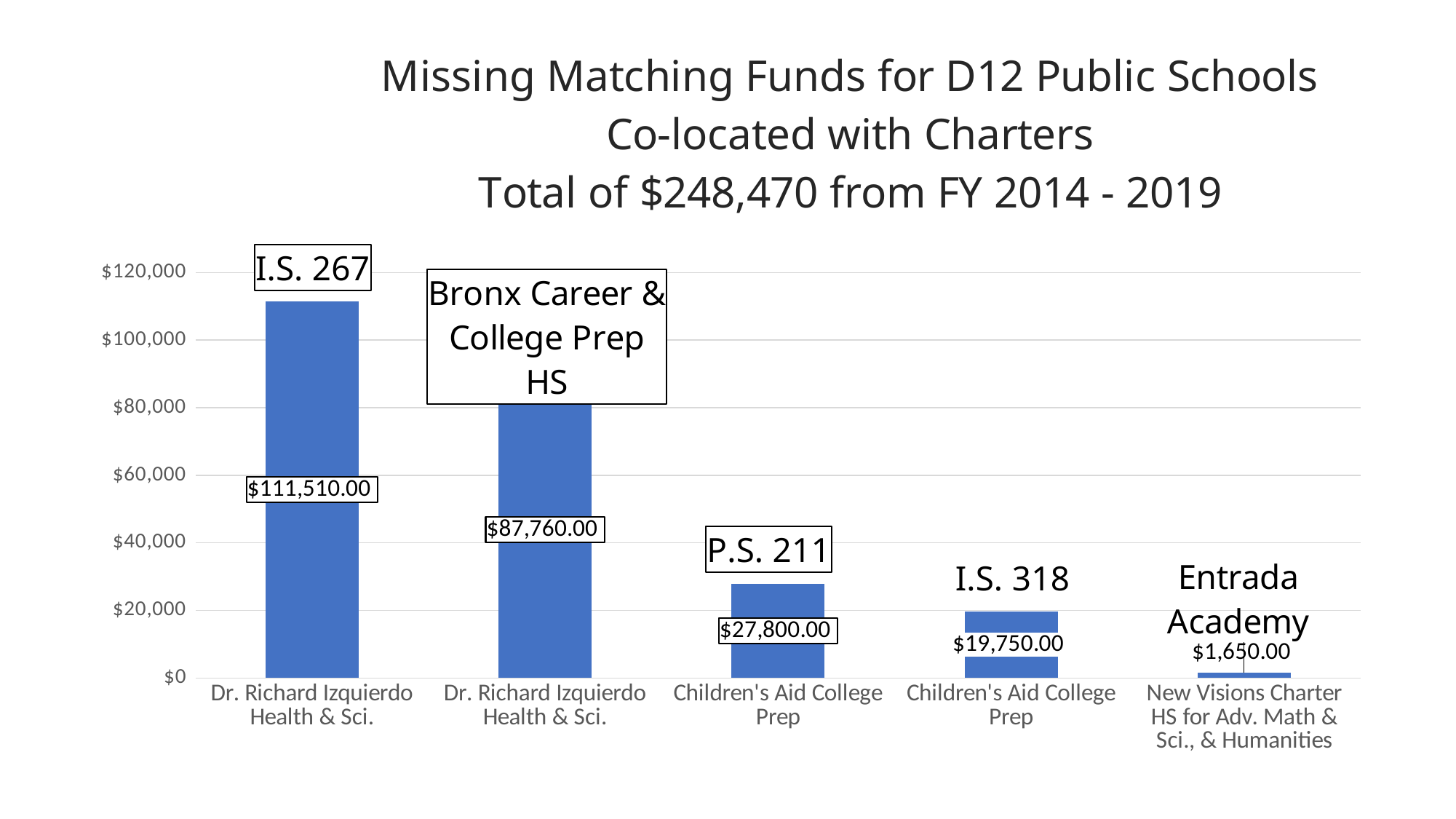
Which school has the highest missing matching funds? I.S. 267 What is the missing matching funds value shown for I.S. 267? $111,510.00 What is the value shown for I.S. 318? $19,750.00 Which school has the lowest missing matching funds? Entrada Academy How much larger is the value for I.S. 267 than the value for Bronx Career & College Prep HS? $23,750.00 What is the value shown for P.S. 211? $27,800.00 What type of chart is shown on the slide? Bar chart What value is labelled on the bar for Bronx Career & College Prep HS? $87,760.00 Which has a larger value, P.S. 211 or I.S. 318? P.S. 211 What is the difference between the values for P.S. 211 and I.S. 318? $8,050.00 What is the value shown for Entrada Academy? $1,650.00 How many bars are plotted in the chart? 5